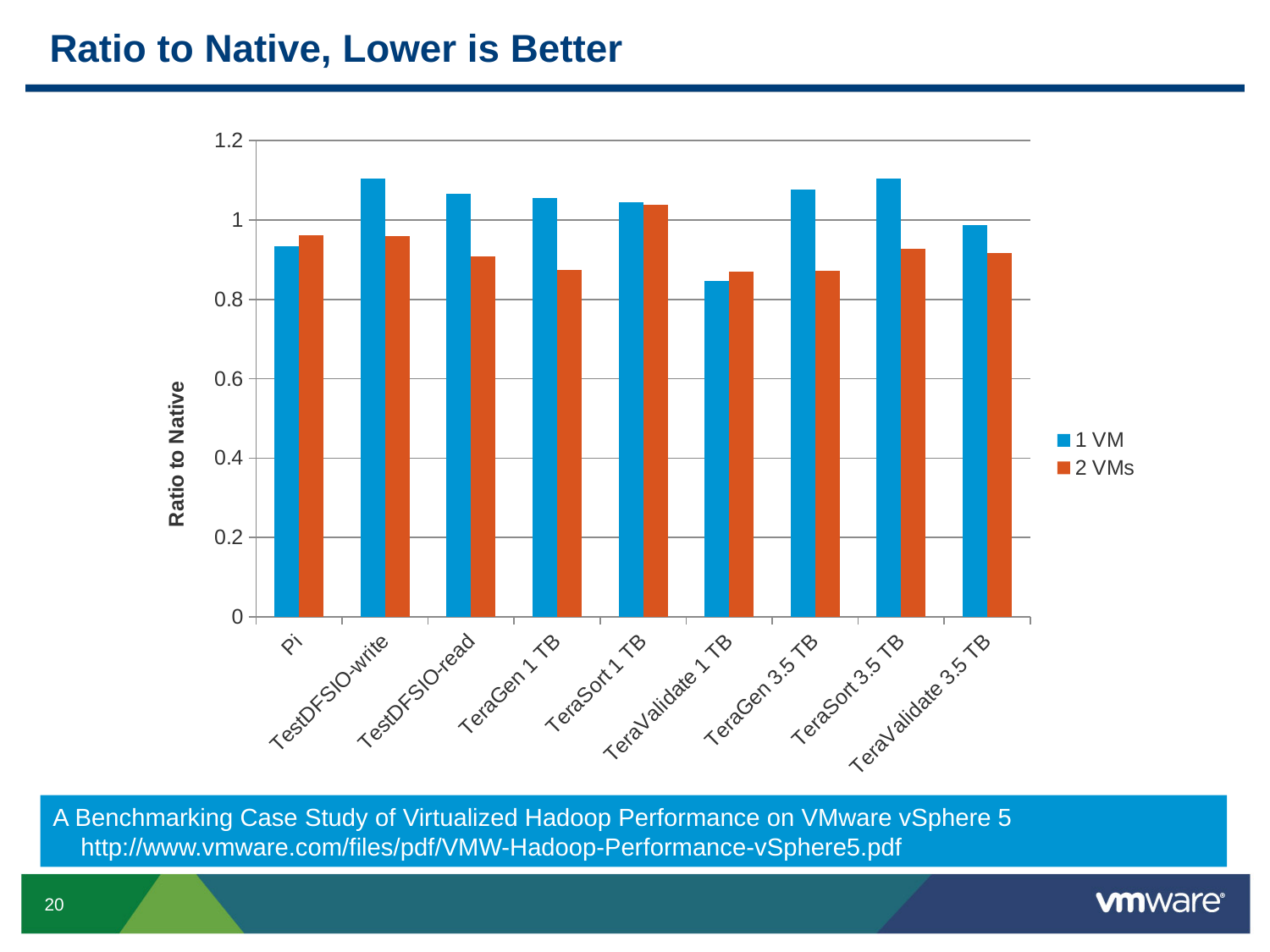
Is the 2 VMs value for TeraGen 1 TB greater or less than 1? less What is the label of the y axis? Ratio to Native How many series does the legend list? 2 Which category has the lowest 1 VM value? TeraValidate 1 TB What kind of chart is shown on the slide? bar chart Which category has the highest 2 VMs value? TeraSort 1 TB Is the 1 VM value for TeraValidate 1 TB greater or less than 1? less How many benchmark categories are shown on the x axis? 9 Is the 2 VMs value for TeraSort 1 TB greater or less than 1? greater For TestDFSIO-read, which is larger: the 1 VM value or the 2 VMs value? 1 VM What are the two series named in the legend? 1 VM and 2 VMs